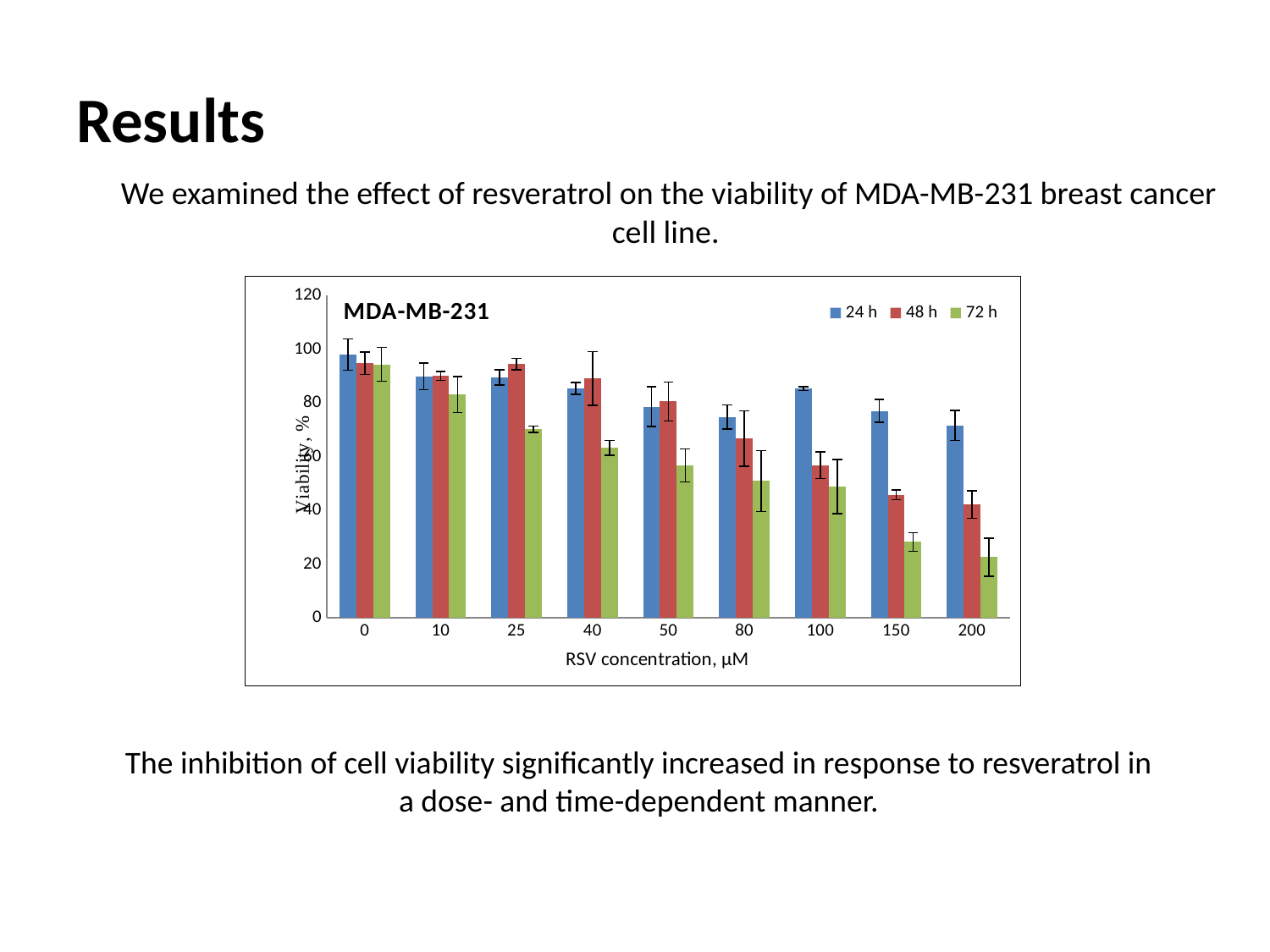
How many RSV concentration categories are shown on the x axis? 9 At 200 µM RSV, which is larger: the 24 h viability or the 72 h viability? 24 h What kind of chart is shown on the slide? bar chart Does the 72 h viability rise or fall as RSV concentration increases along the x axis? fall Is the 72 h viability at 200 µM greater or less than 40? less What is the x-axis label of the chart? RSV concentration, µM How many series does the chart legend list? 3 At which RSV concentration is the 72 h viability highest? 0 Is the 72 h viability at 150 µM greater or less than 40? less At which RSV concentration is the 72 h viability lowest? 200 Is the 24 h viability at 0 µM greater or less than 80? greater What is the title shown inside the chart? MDA-MB-231